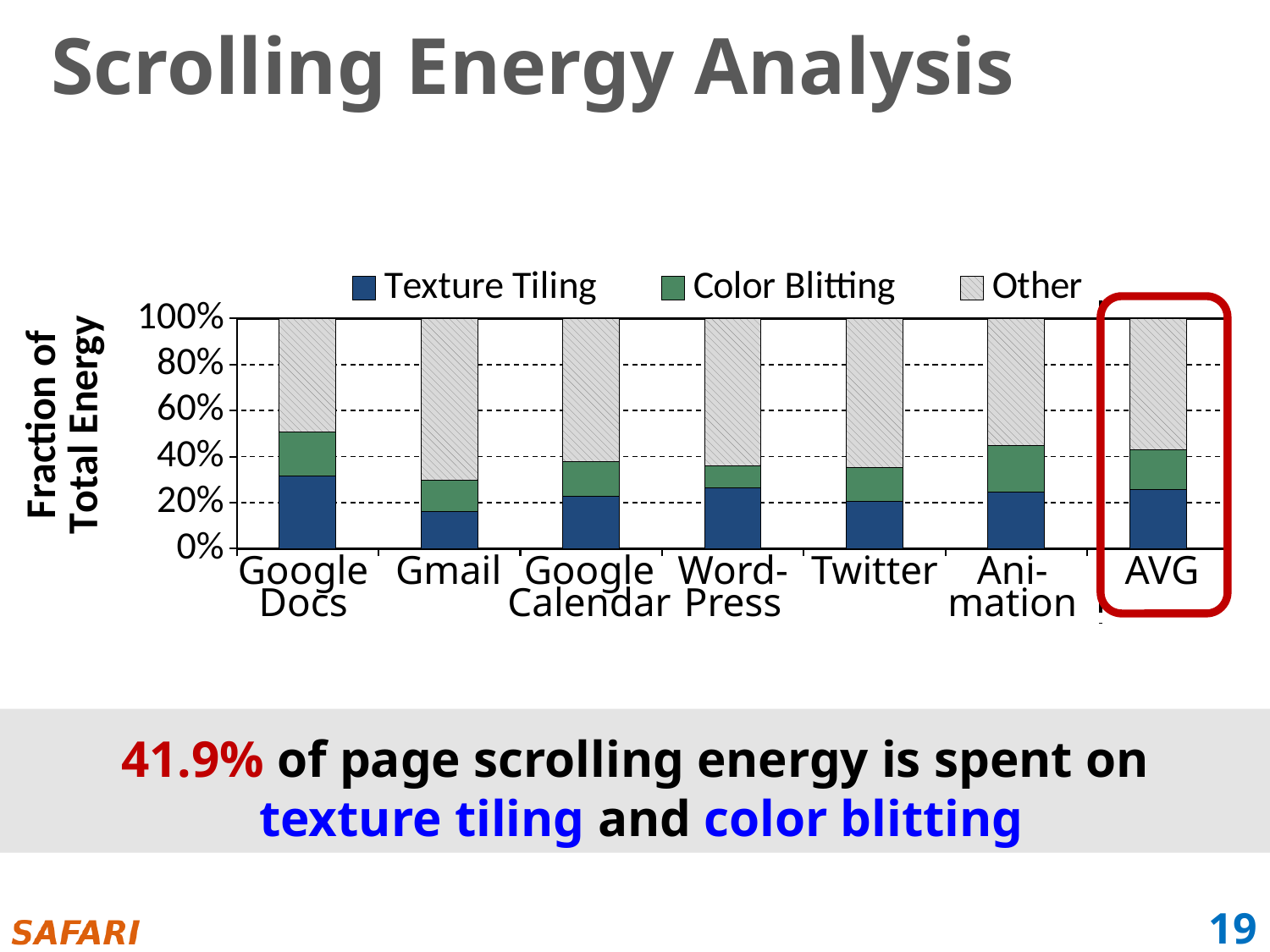
What kind of chart is shown on the slide? Stacked bar chart Is the Texture Tiling value for Google Docs greater or less than 20%? greater What are the three series listed in the chart's legend? Texture Tiling, Color Blitting, Other Which category has the smallest Texture Tiling share? Gmail How many categories are shown along the x axis of the chart? 7 Is the combined Texture Tiling and Color Blitting share for Gmail greater or less than 40%? less Which has the larger Texture Tiling share, Google Docs or Gmail? Google Docs Which category has the largest Texture Tiling share? Google Docs Is the Texture Tiling value for Gmail greater or less than 20%? less How many series does the chart's legend list? 3 Which category on the x axis is highlighted with a red box? AVG